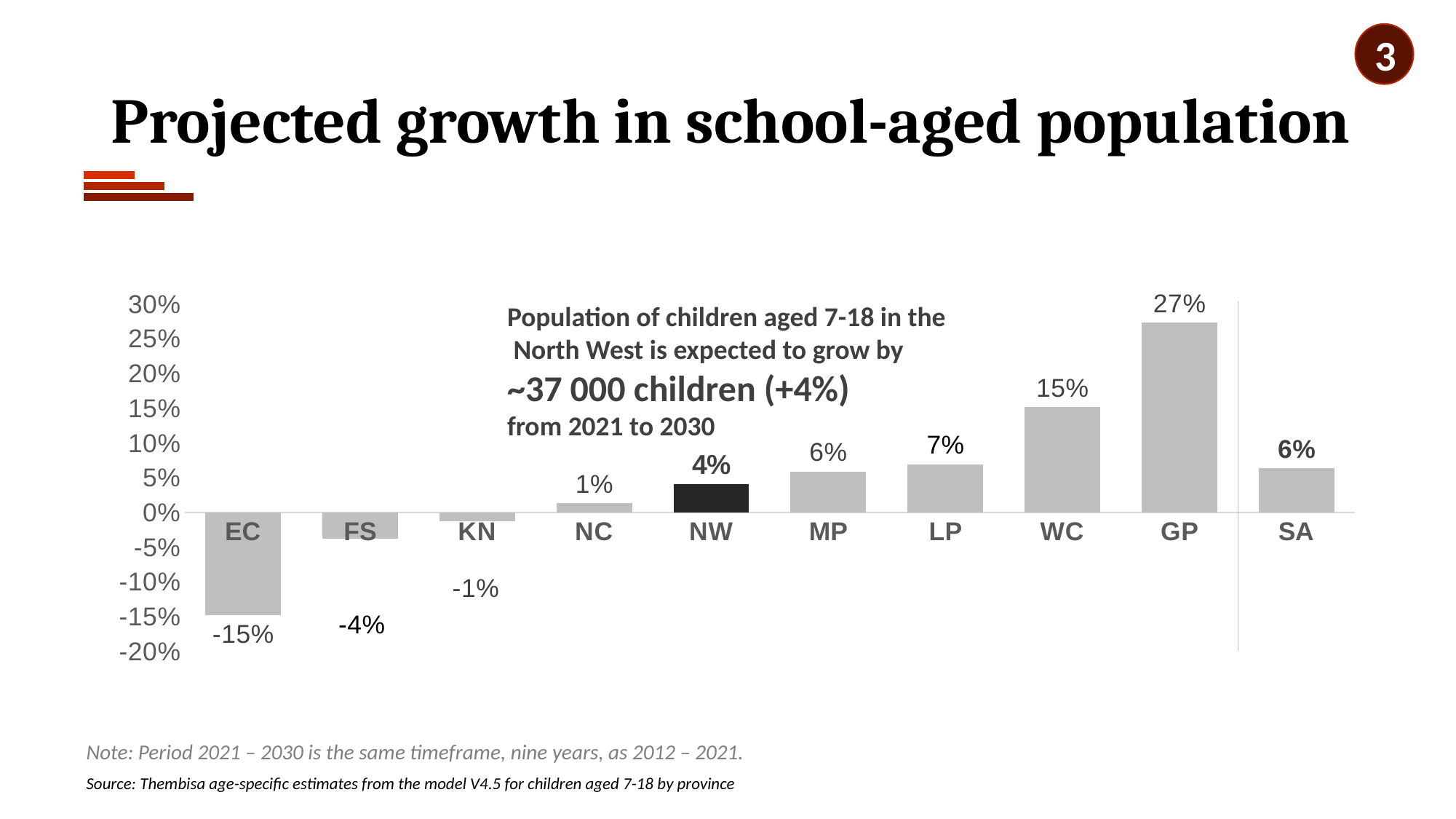
Is the value for WC greater or less than 10%? greater What is the projected growth for SA? 6% Which bar is shaded darker than the others? NW What kind of chart is shown on the slide? Bar chart Which province has the lowest projected growth? EC What is the projected growth for NW? 4% Which province has the highest projected growth? GP How many categories are shown on the x axis? 10 What is the projected growth for EC? -15% What is the projected growth for GP? 27% What is the difference between the projected growth for GP and WC? 12 percentage points Which has a larger projected growth, LP or MP? LP